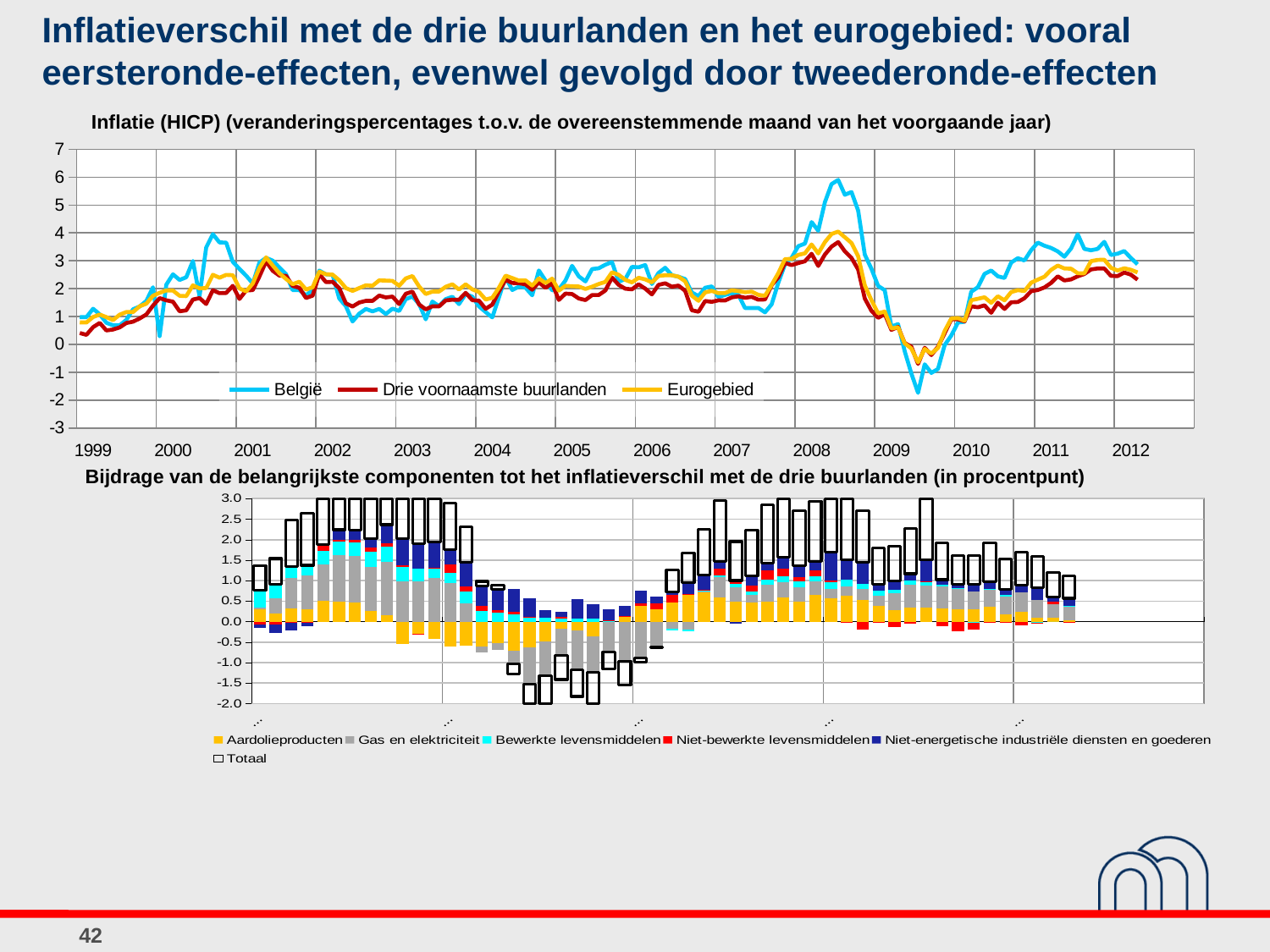
In the bottom chart 'Bijdrage van de belangrijkste componenten', how many entries does the legend list? 6 What kind of chart is the bottom chart titled 'Bijdrage van de belangrijkste componenten tot het inflatieverschil met de drie buurlanden'? bar chart What kind of chart is the top chart titled 'Inflatie (HICP)'? line chart In the top chart 'Inflatie (HICP)', is the peak value for Drie voornaamste buurlanden in 2008 greater or less than 3? greater In the top chart 'Inflatie (HICP)', what is the first year shown on the x axis? 1999 In the top chart 'Inflatie (HICP)', how many series does the legend list? 3 In the top chart 'Inflatie (HICP)', which series reaches the highest value in 2008? België In the top chart 'Inflatie (HICP)', which series falls to the lowest value in 2009? België In the top chart 'Inflatie (HICP)', does the België series rise or fall between its 2008 peak and 2009? fall In the top chart 'Inflatie (HICP)', is the lowest value for België in 2009 greater or less than -1? less In the bottom chart 'Bijdrage van de belangrijkste componenten', which legend entry is shown in yellow? Aardolieproducten In the top chart 'Inflatie (HICP)', is the peak value for België in 2008 greater or less than 5? greater